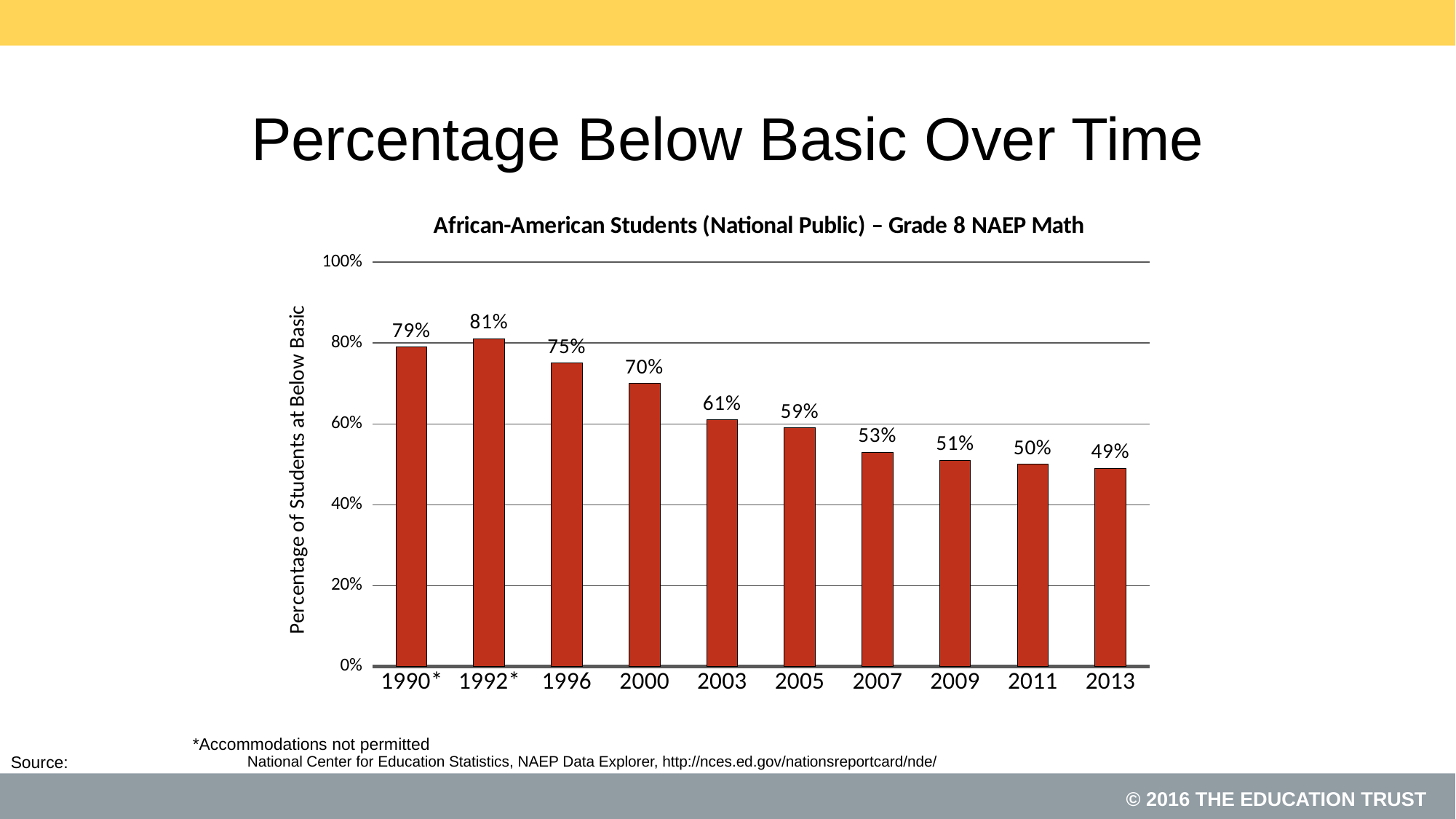
Is the value for 2011 greater or less than 60%? less What kind of chart is shown on the slide? Bar chart What is the difference between the 1990* value and the 2013 value? 30 percentage points What is the difference between the values for 2003 and 2005? 2 percentage points Which year has the highest percentage of students at Below Basic? 1992* What is the value shown for 2013? 49% What percentage is shown for 1996? 75% Which is larger, the value for 2007 or the value for 2009? 2007 Do the values generally rise or fall from 1992* to 2013? Fall How many years are shown on the x axis? 10 Which year has the lowest percentage of students at Below Basic? 2013 What percentage of African-American students were at Below Basic in 2000? 70%